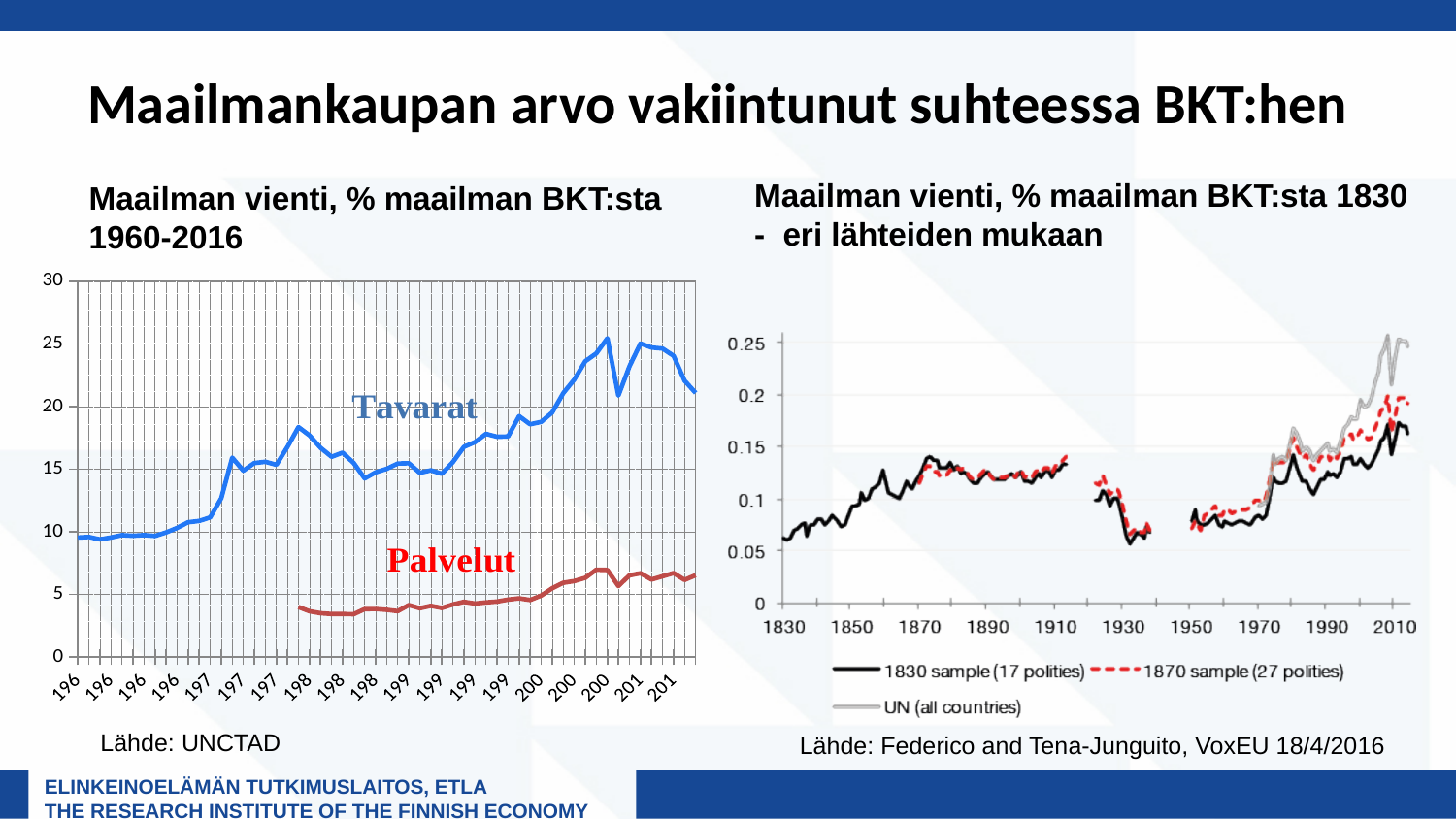
How many series are plotted in the left chart (1960-2016)? 2 In the left chart (1960-2016), which series is higher throughout, Tavarat or Palvelut? Tavarat In the left chart (1960-2016), is the value for Palvelut at the end of the period greater or less than 10? less In the right chart (from 1830), which series is higher around 2010, UN (all countries) or 1830 sample (17 polities)? UN (all countries) What kind of chart is the left chart titled "Maailman vienti, % maailman BKT:sta 1960-2016"? line chart What kind of chart is the right chart titled "Maailman vienti, % maailman BKT:sta 1830 - eri lähteiden mukaan"? line chart What is the source given for the left chart (1960-2016)? UNCTAD In the left chart (1960-2016), does the Tavarat series overall rise or fall from 1960 to its peak in the late 2000s? rise In the left chart (1960-2016), what colour is the Palvelut line? red In the left chart (1960-2016), is the value for Tavarat at the end of the period greater or less than 20? greater In the right chart (from 1830), is the value of the 1830 sample series at 1830 greater or less than 0.1? less How many series does the legend of the right chart list? 3